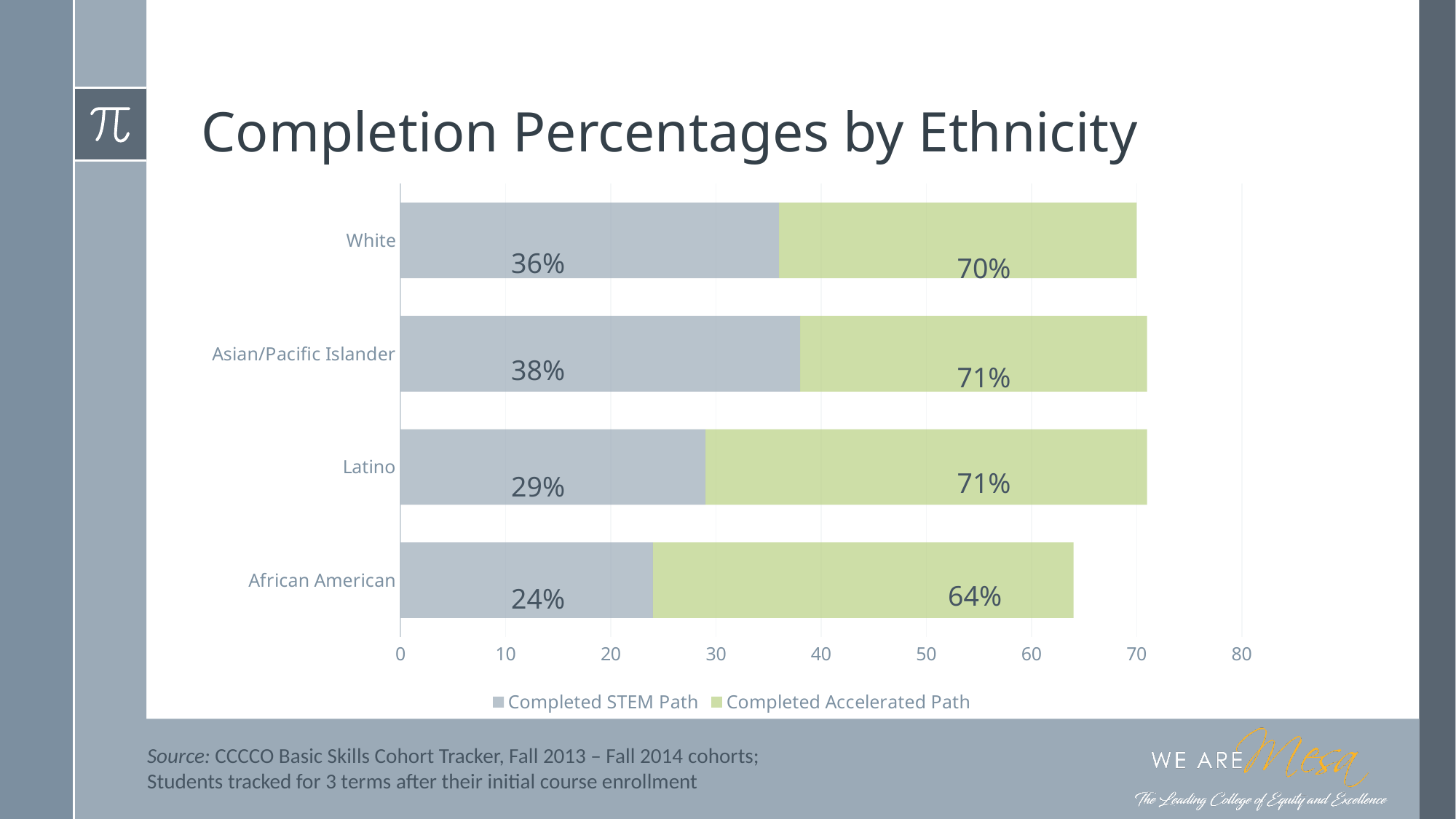
What kind of chart is shown on the slide? Bar chart Is the Completed STEM Path value for African American greater or less than 30? less Which ethnicity has the lowest Completed Accelerated Path percentage? African American How many ethnicity categories are shown in the chart? 4 What is the Completed Accelerated Path value for Asian/Pacific Islander? 71% How many series does the legend list? 2 What is the Completed STEM Path value for White? 36% What is the difference between the Completed Accelerated Path and Completed STEM Path values for Latino? 42 percentage points What is the Completed STEM Path value for Latino? 29% What is the Completed Accelerated Path value for African American? 64% Which is larger: the Completed STEM Path value for White or for Latino? White Which ethnicity has the highest Completed STEM Path percentage? Asian/Pacific Islander